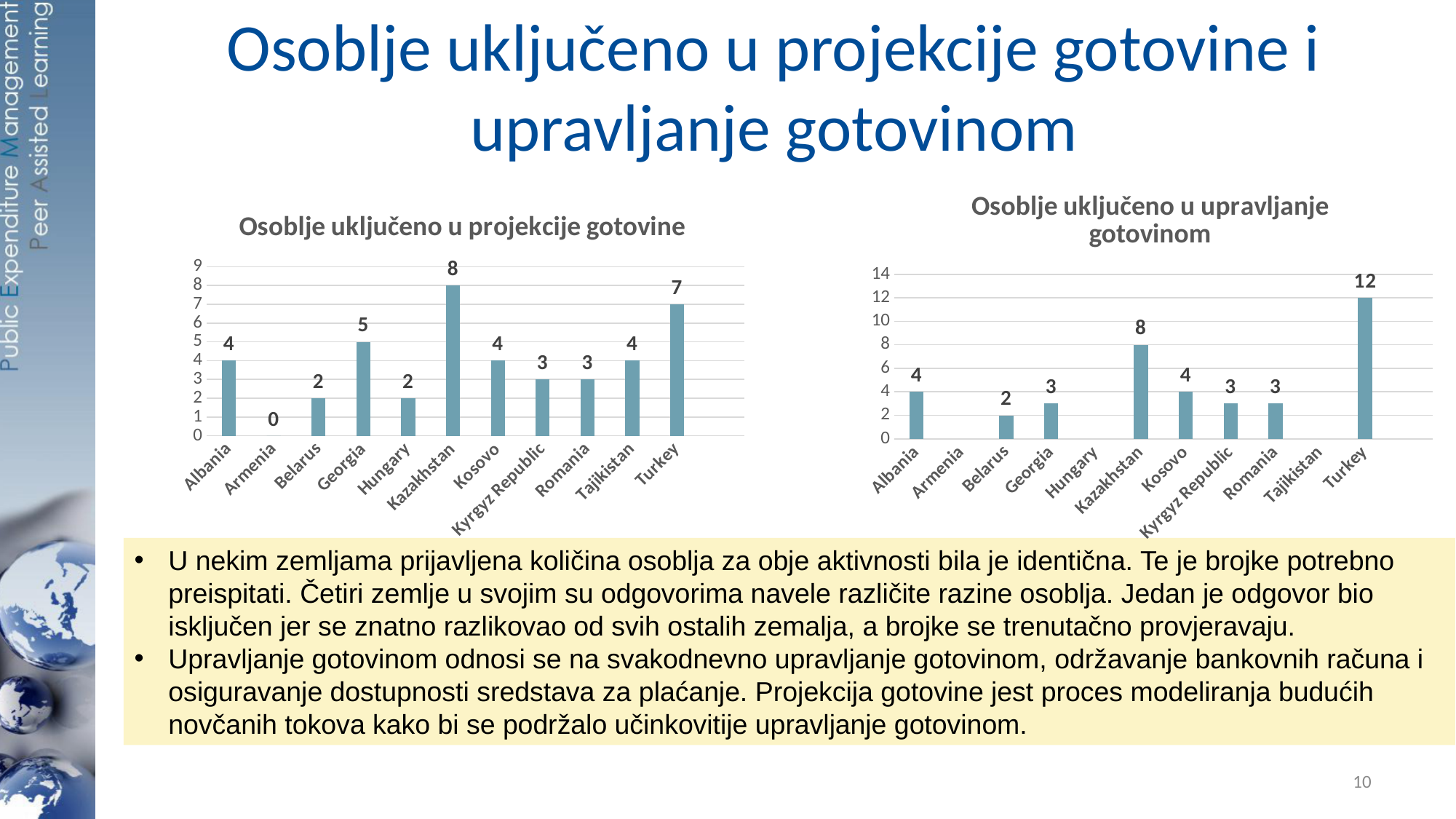
In the chart 'Osoblje uključeno u upravljanje gotovinom', what is the difference between the values for Turkey and Kazakhstan? 4 In the chart 'Osoblje uključeno u upravljanje gotovinom', which is larger, the value for Kazakhstan or the value for Kosovo? Kazakhstan In the chart 'Osoblje uključeno u upravljanje gotovinom', what is the value for Turkey? 12 In the chart 'Osoblje uključeno u projekcije gotovine', what is the difference between the values for Turkey and Hungary? 5 In the chart 'Osoblje uključeno u projekcije gotovine', how many countries are shown on the x axis? 11 In the chart 'Osoblje uključeno u projekcije gotovine', which country has the highest value? Kazakhstan What type of chart is the chart 'Osoblje uključeno u upravljanje gotovinom'? Bar chart In the chart 'Osoblje uključeno u upravljanje gotovinom', what is the value for Belarus? 2 In the chart 'Osoblje uključeno u projekcije gotovine', what is the value for Georgia? 5 In the chart 'Osoblje uključeno u projekcije gotovine', what is the value for Kazakhstan? 8 In the chart 'Osoblje uključeno u projekcije gotovine', which country has the lowest value? Armenia In the chart 'Osoblje uključeno u upravljanje gotovinom', which country has the highest value? Turkey